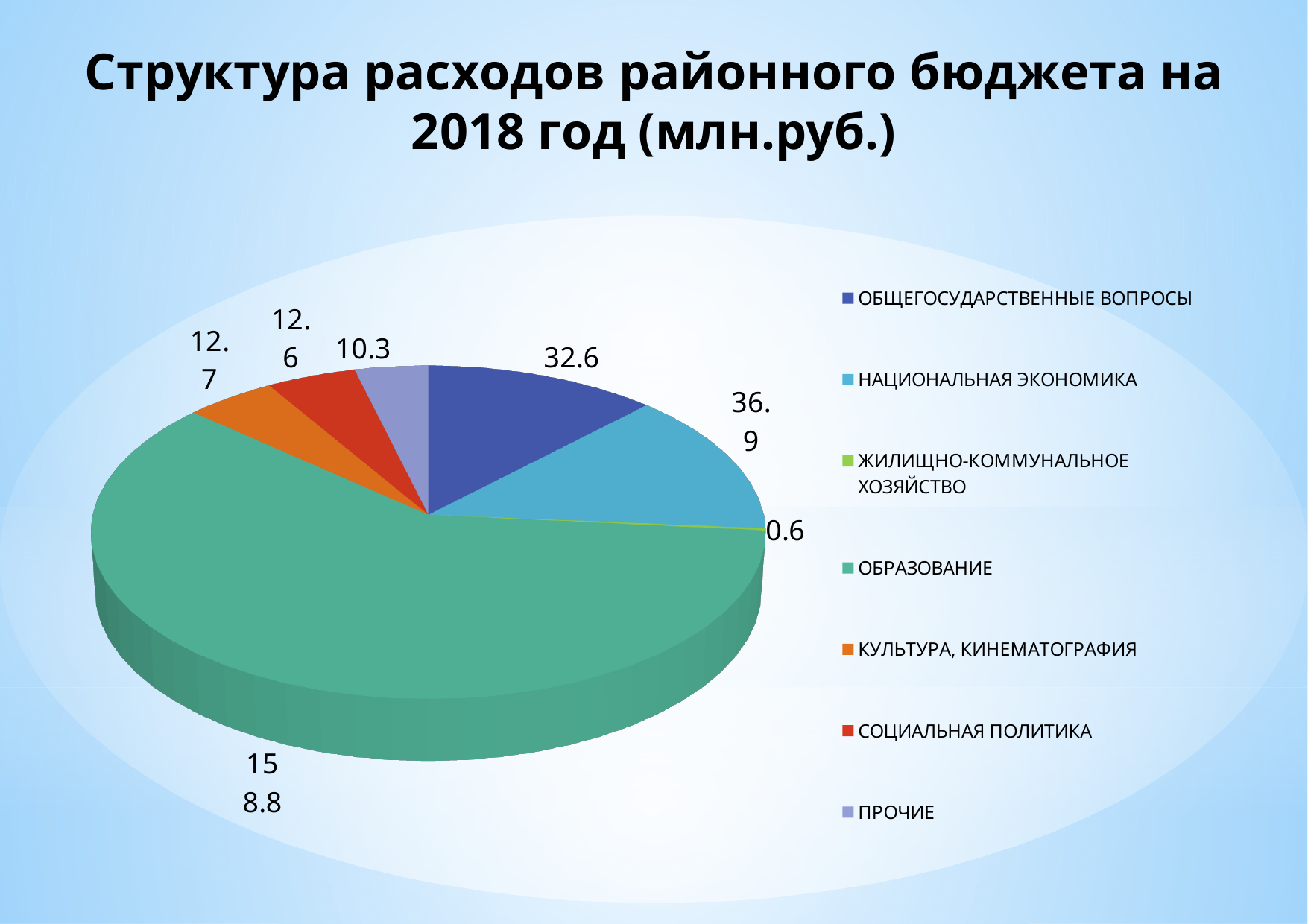
What is the value for ЖИЛИЩНО-КОММУНАЛЬНОЕ ХОЗЯЙСТВО? 0.6 What is the difference between the values for НАЦИОНАЛЬНАЯ ЭКОНОМИКА and ОБЩЕГОСУДАРСТВЕННЫЕ ВОПРОСЫ? 4.3 How many categories does the pie chart have? 7 What is the value for НАЦИОНАЛЬНАЯ ЭКОНОМИКА? 36.9 Which category has the smallest slice of the pie? ЖИЛИЩНО-КОММУНАЛЬНОЕ ХОЗЯЙСТВО Which category has the largest slice of the pie? ОБРАЗОВАНИЕ Which is larger, the value for ОБЩЕГОСУДАРСТВЕННЫЕ ВОПРОСЫ or the value for ПРОЧИЕ? ОБЩЕГОСУДАРСТВЕННЫЕ ВОПРОСЫ What is the value for ПРОЧИЕ? 10.3 What is the title of the chart? Структура расходов районного бюджета на 2018 год (млн.руб.) What kind of chart is shown on the slide? Pie chart What is the value for ОБРАЗОВАНИЕ? 158.8 What is the value for ОБЩЕГОСУДАРСТВЕННЫЕ ВОПРОСЫ? 32.6